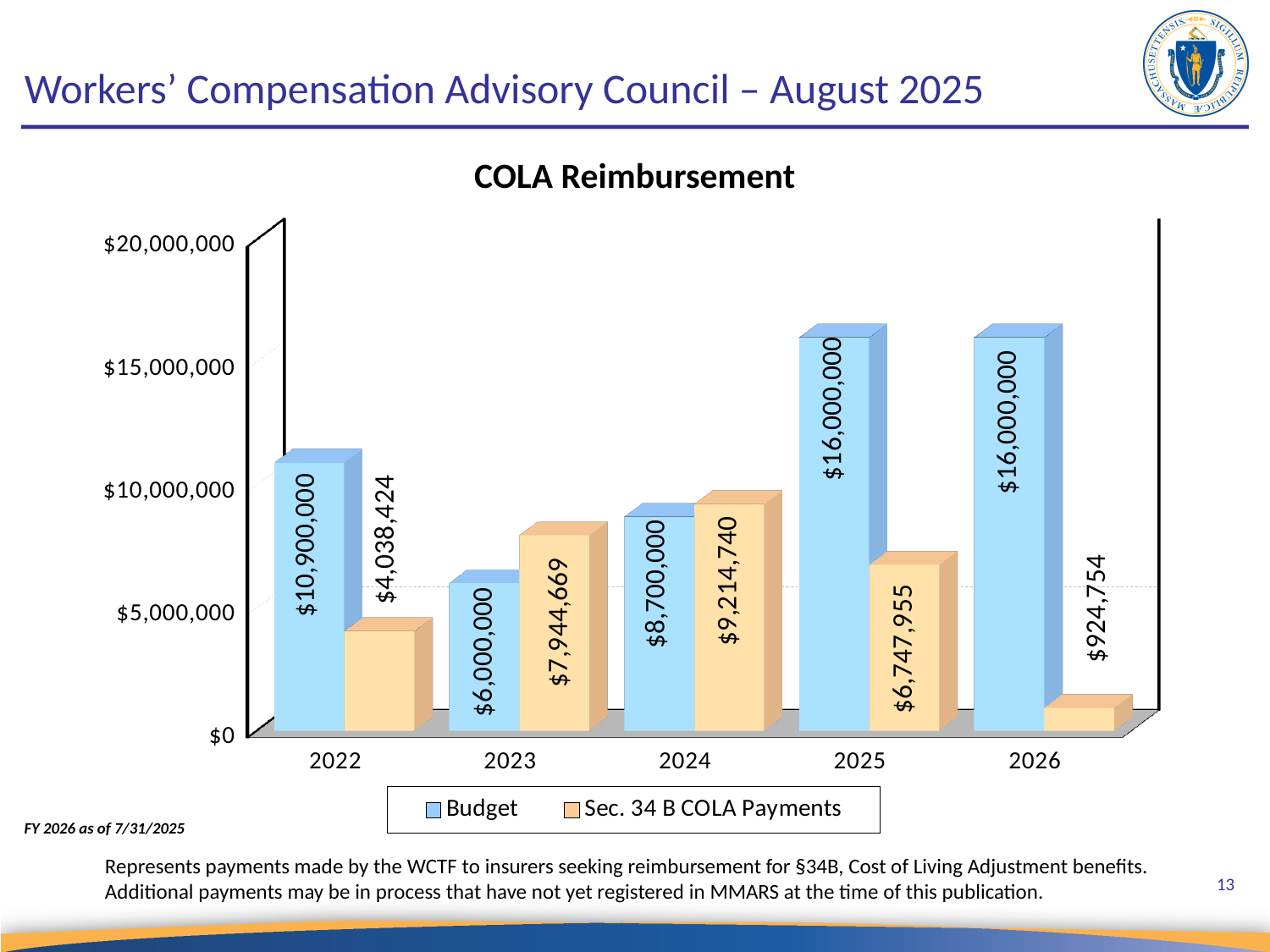
Which year has the lowest Sec. 34 B COLA Payments value? 2026 Which year has the highest Sec. 34 B COLA Payments value? 2024 What type of chart is shown? Bar chart What is the Sec. 34 B COLA Payments value for 2026? $924,754 What is the difference between the Budget and the Sec. 34 B COLA Payments in 2025? $9,252,045 In 2023, which is larger: the Budget or the Sec. 34 B COLA Payments? Sec. 34 B COLA Payments What is the difference between the Budget and the Sec. 34 B COLA Payments in 2022? $6,861,576 How many years are shown on the x axis? 5 What is the Budget value for 2022? $10,900,000 Which year has the lowest Budget value? 2023 How many series does the legend list? 2 What is the Sec. 34 B COLA Payments value for 2024? $9,214,740